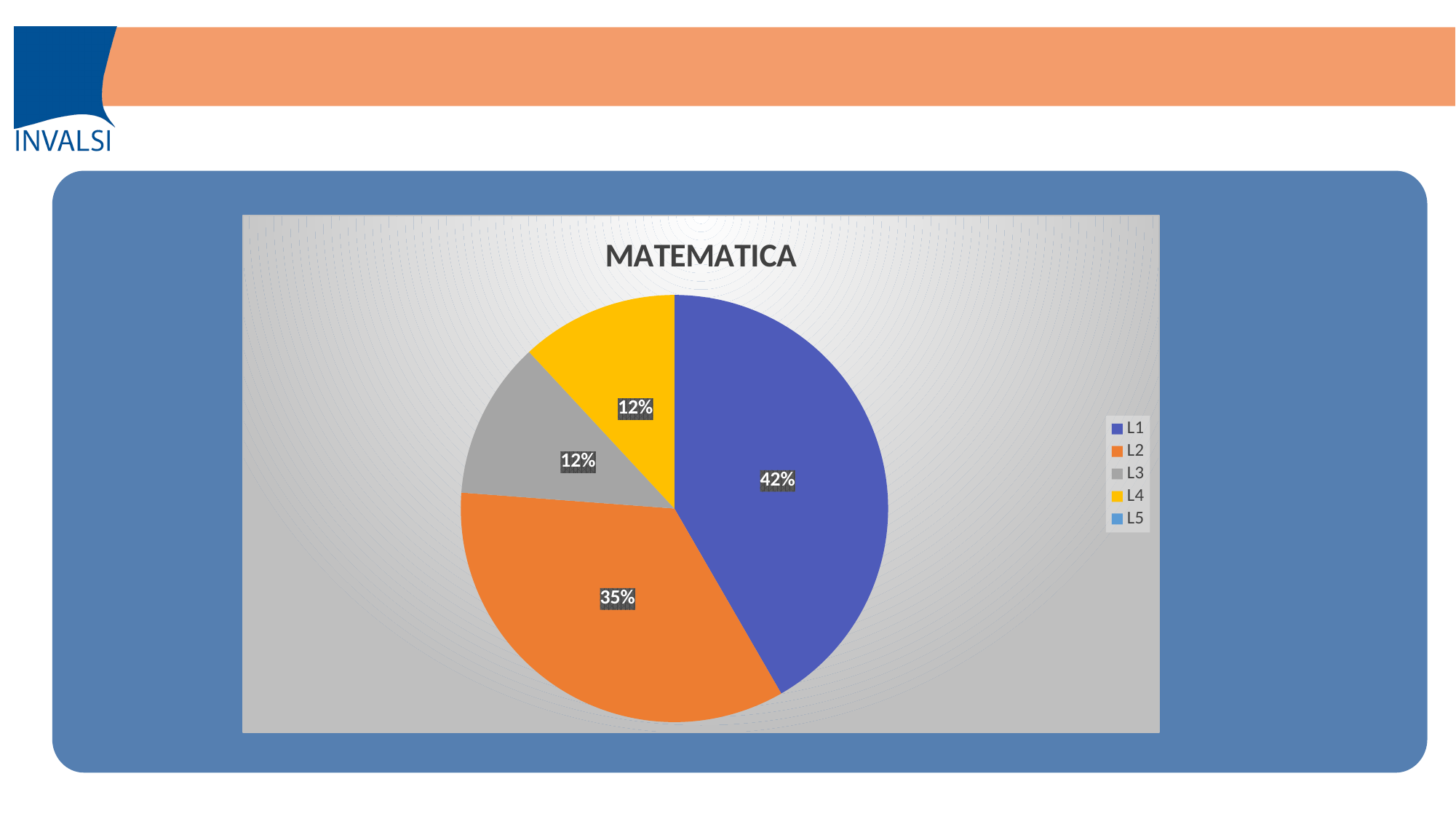
What type of chart is shown on the slide? Pie chart How many entries does the legend of the chart list? 5 What percentage does the L3 slice represent in the MATEMATICA pie chart? 12% What percentage does the L2 slice represent in the MATEMATICA pie chart? 35% What percentage does the L4 slice represent in the MATEMATICA pie chart? 12% Which slice is larger, L1 or L2? L1 What colour is the L2 slice in the pie chart? Orange What is the difference in percentage points between the L1 and L2 slices? 7% What percentage does the L1 slice represent in the MATEMATICA pie chart? 42% What is the combined share of the L1 and L2 slices? 77% What is the title of the chart? MATEMATICA Which level has the largest slice in the MATEMATICA pie chart? L1